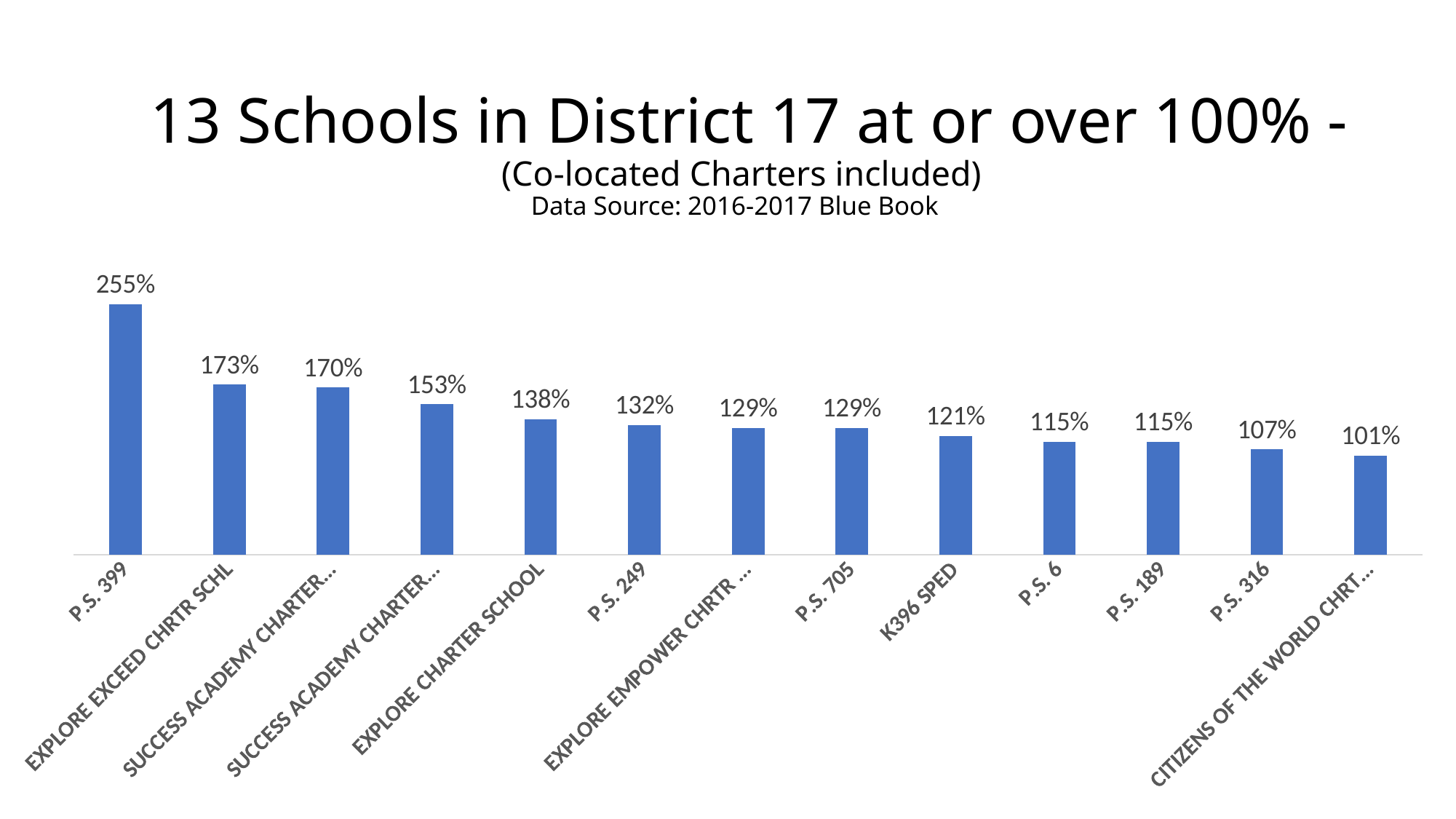
How many schools are shown in the chart? 13 What is the difference between the values for P.S. 399 and Explore Exceed Chrtr Schl? 82% Do the values rise or fall from left to right along the x axis? Fall Which school has the highest value? P.S. 399 What is the value for P.S. 399? 255% What kind of chart is shown on the slide? Bar chart Which is larger, the value for P.S. 249 or the value for P.S. 6? P.S. 249 What is the value for P.S. 316? 107% What is the value for Explore Exceed Chrtr Schl? 173% What is the value for K396 SPED? 121% What is the value for P.S. 705? 129% What is the value for Explore Charter School? 138%